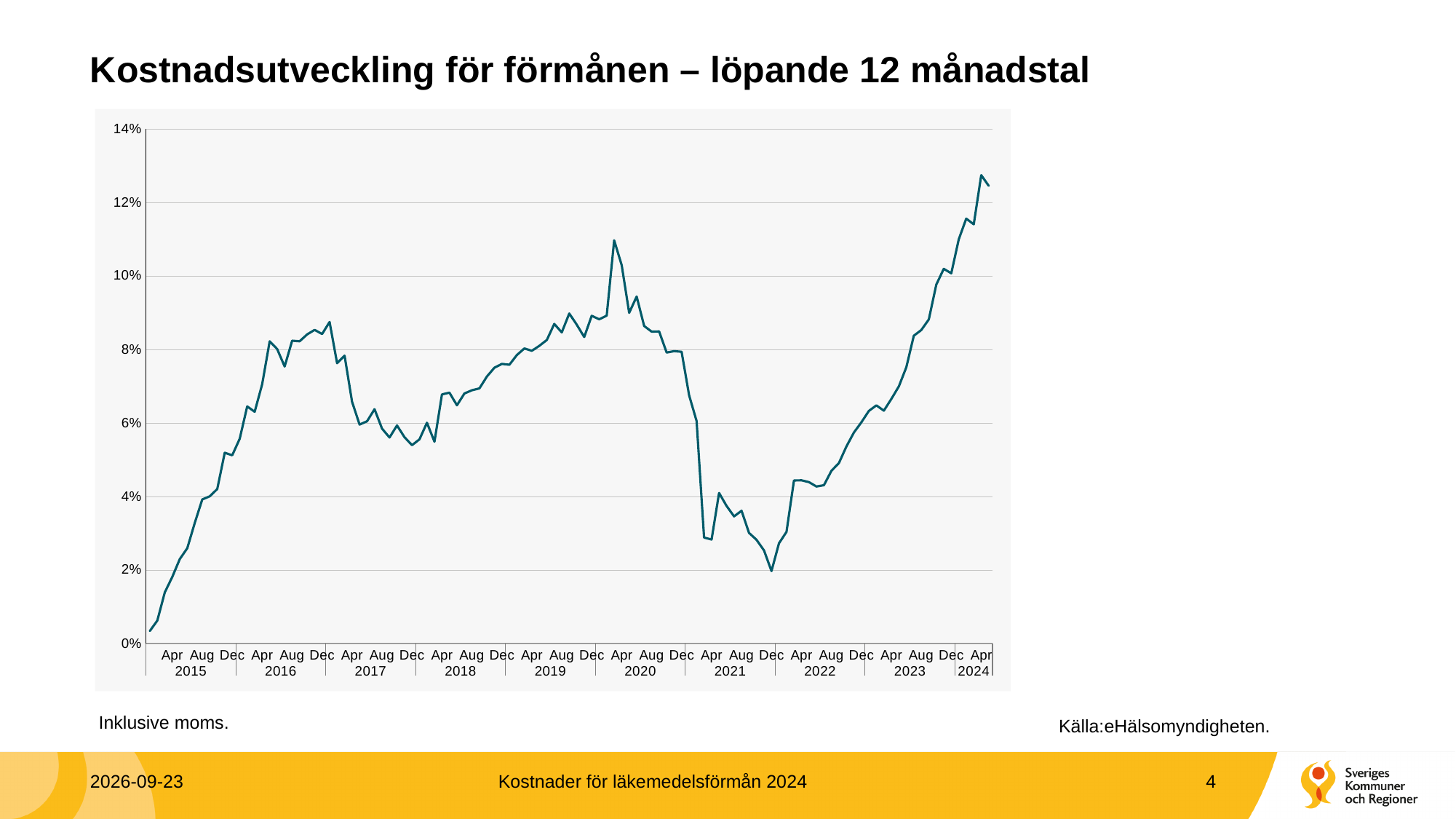
What is the title of the chart? Kostnadsutveckling för förmånen – löpande 12 månadstal What kind of chart is shown on the slide? line chart Is the value at Apr 2024 greater or less than 12%? greater How many years are labelled on the x axis of the chart? 10 In which year does the line reach its lowest value? 2015 Is the value at Apr 2020 greater or less than 10%? greater Is the value at Dec 2016 greater or less than 8%? greater In which year does the line reach its highest value? 2024 Does the line rise or fall between Dec 2021 and Apr 2024? rise